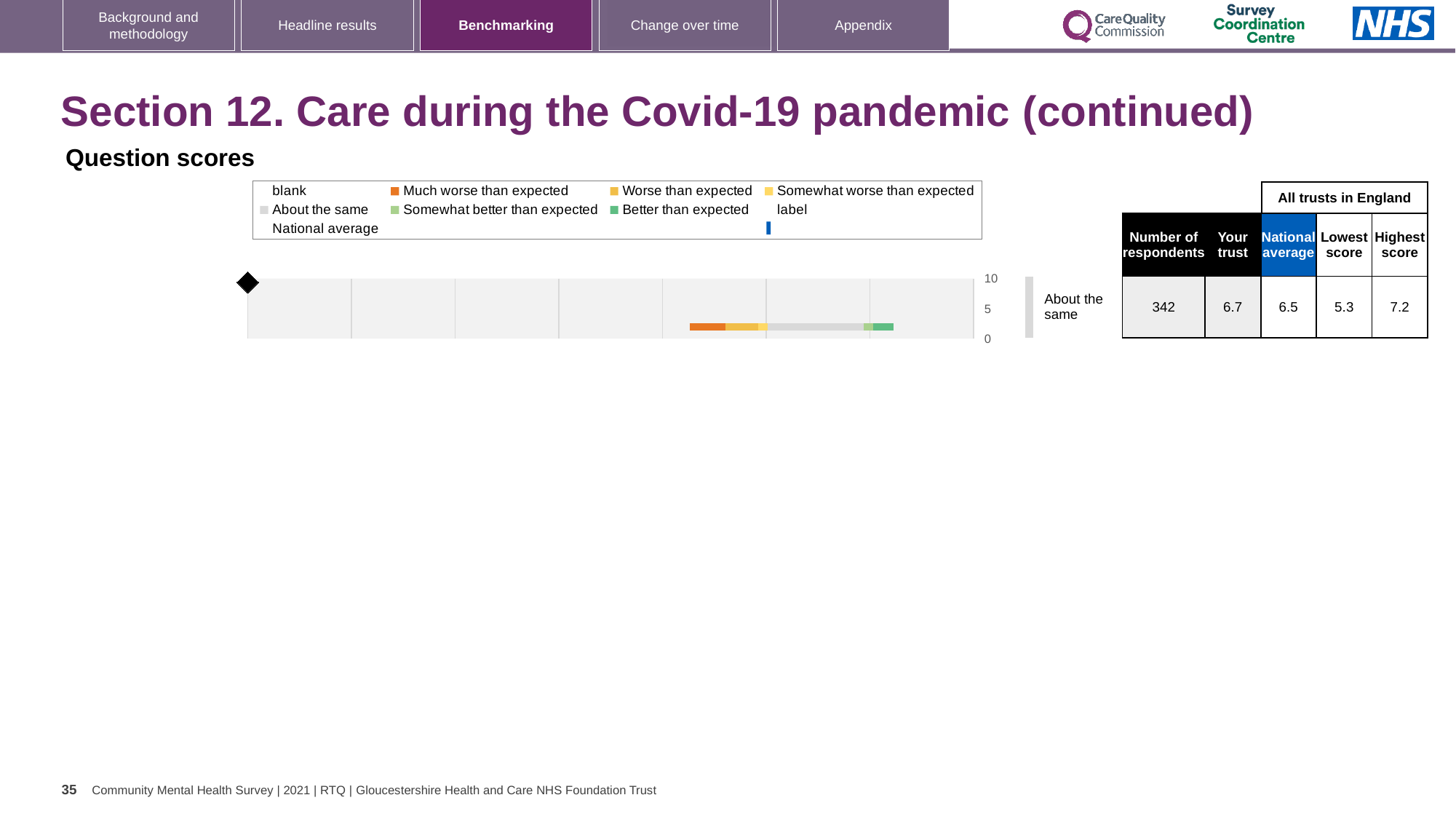
What kind of chart is shown under 'Question scores'? bar chart Which is larger, the 'Your trust' score or the National average score? Your trust What is the highest value shown on the chart's axis? 10 What is the difference between the Highest score and the Lowest score in the table? 1.9 According to the table, what is the National average score? 6.5 According to the table, how many respondents are there for this question? 342 According to the table, what is the 'Your trust' score? 6.7 What benchmark category label is shown next to the bar for this question? About the same According to the table, what is the Lowest score among all trusts in England? 5.3 How many bars (questions) are plotted in the Question scores chart? 1 Which legend entry is shown in orange? Much worse than expected According to the table, what is the Highest score among all trusts in England? 7.2